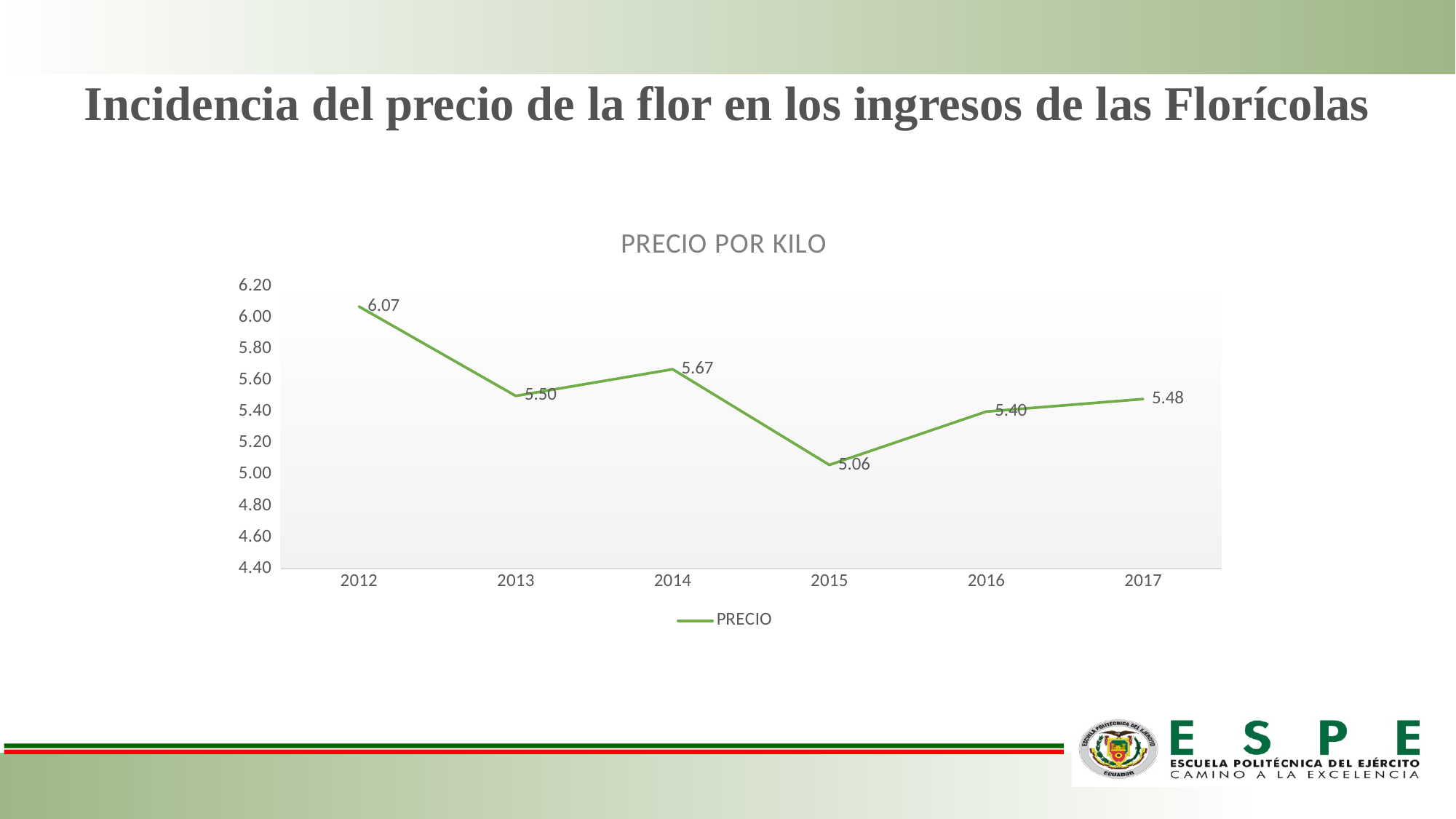
What kind of chart is shown? line chart What is the value for 2017? 5.48 Which year has the lowest price per kilo? 2015 What is the difference between the values for 2012 and 2015? 1.01 What is the title of the chart? PRECIO POR KILO How many years are plotted on the chart? 6 Which is larger, the value for 2016 or the value for 2017? 2017 What is the value for 2012? 6.07 What is the difference between the values for 2014 and 2013? 0.17 Is the value for 2014 greater or less than 5.60? greater What is the value for 2015? 5.06 Which year has the highest price per kilo? 2012